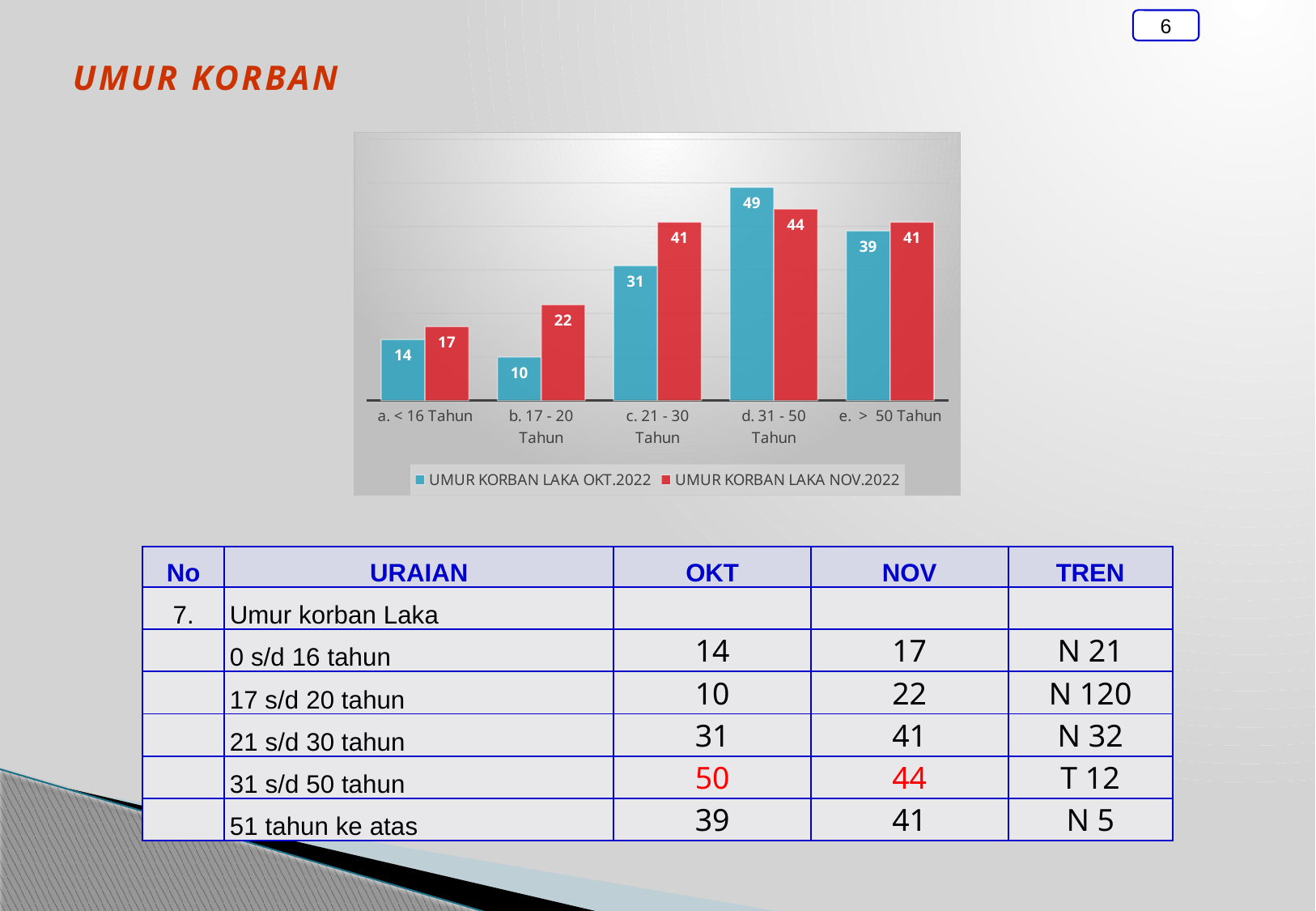
How many age categories are shown on the x axis of the chart? 5 What is the value for UMUR KORBAN LAKA NOV.2022 in the category b. 17 - 20 Tahun? 22 How many series does the chart legend list? 2 Which category has the highest value for UMUR KORBAN LAKA NOV.2022? d. 31 - 50 Tahun What type of chart is shown on the slide? bar chart What is the value for UMUR KORBAN LAKA OKT.2022 in the category d. 31 - 50 Tahun? 49 What is the difference between the OKT.2022 and NOV.2022 values in the category e. > 50 Tahun? 2 What is the value for UMUR KORBAN LAKA OKT.2022 in the category a. < 16 Tahun? 14 Which colour represents the series UMUR KORBAN LAKA NOV.2022 in the chart? red Which category has the lowest value for UMUR KORBAN LAKA OKT.2022? b. 17 - 20 Tahun What is the difference between the NOV.2022 and OKT.2022 values in the category c. 21 - 30 Tahun? 10 In the category d. 31 - 50 Tahun, which series has the larger value, OKT.2022 or NOV.2022? OKT.2022